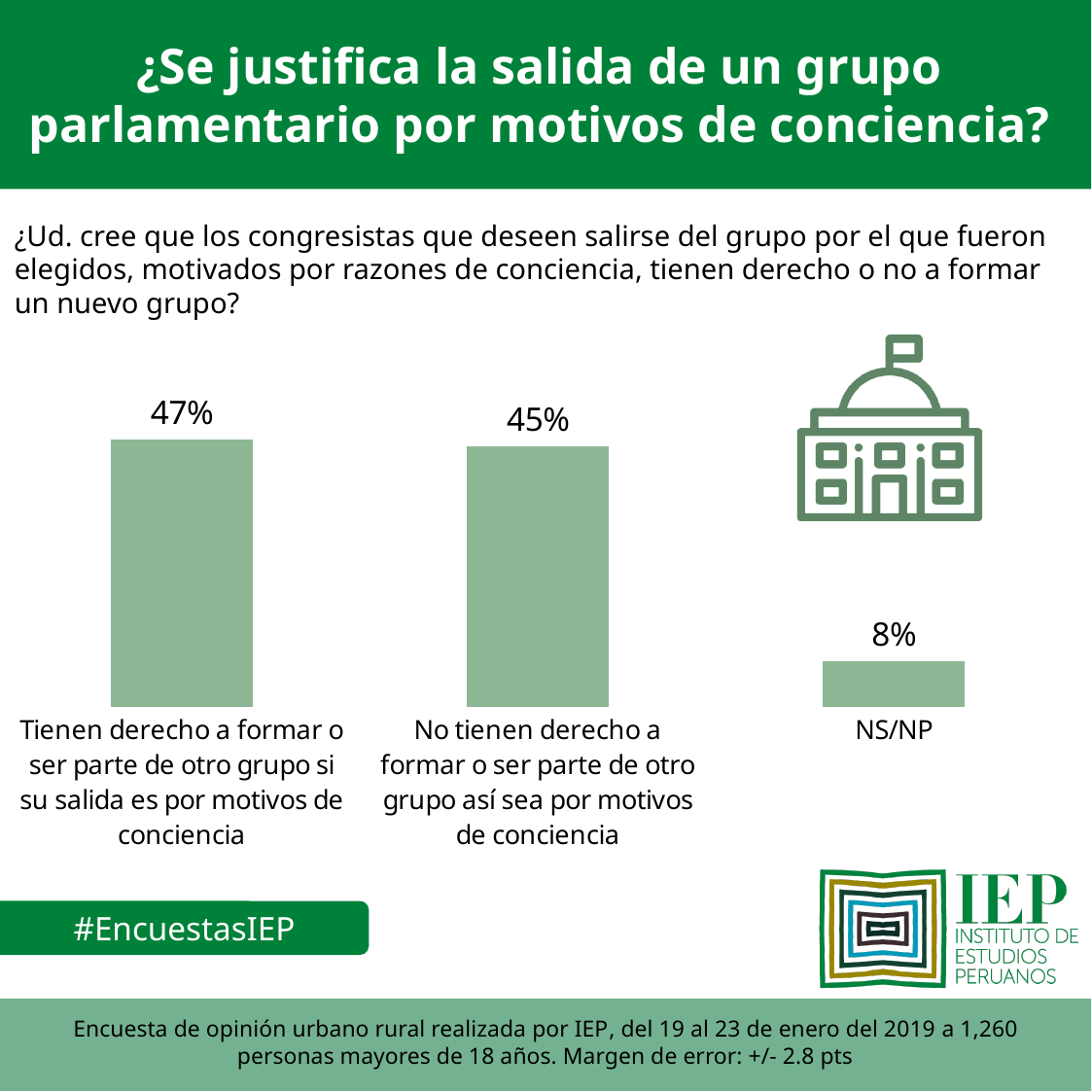
What percentage of respondents say congresistas do not have the right to form or be part of another group even for reasons of conscience? 45% What kind of chart is shown on the slide? Bar chart What is the difference in percentage points between the 'Tienen derecho' and 'No tienen derecho' responses? 2 Which response category has the highest percentage? Tienen derecho a formar o ser parte de otro grupo si su salida es por motivos de conciencia What percentage of respondents answered NS/NP? 8% What is the title of the slide? ¿Se justifica la salida de un grupo parlamentario por motivos de conciencia? What is the total of the three percentages shown in the chart? 100% What is the difference in percentage points between the 'No tienen derecho' response and NS/NP? 37 Which is larger: the percentage for 'Tienen derecho' or the percentage for NS/NP? Tienen derecho Which response category has the lowest percentage? NS/NP How many response categories are shown in the chart? 3 What percentage of respondents say congresistas have the right to form or be part of another group if they leave for reasons of conscience? 47%